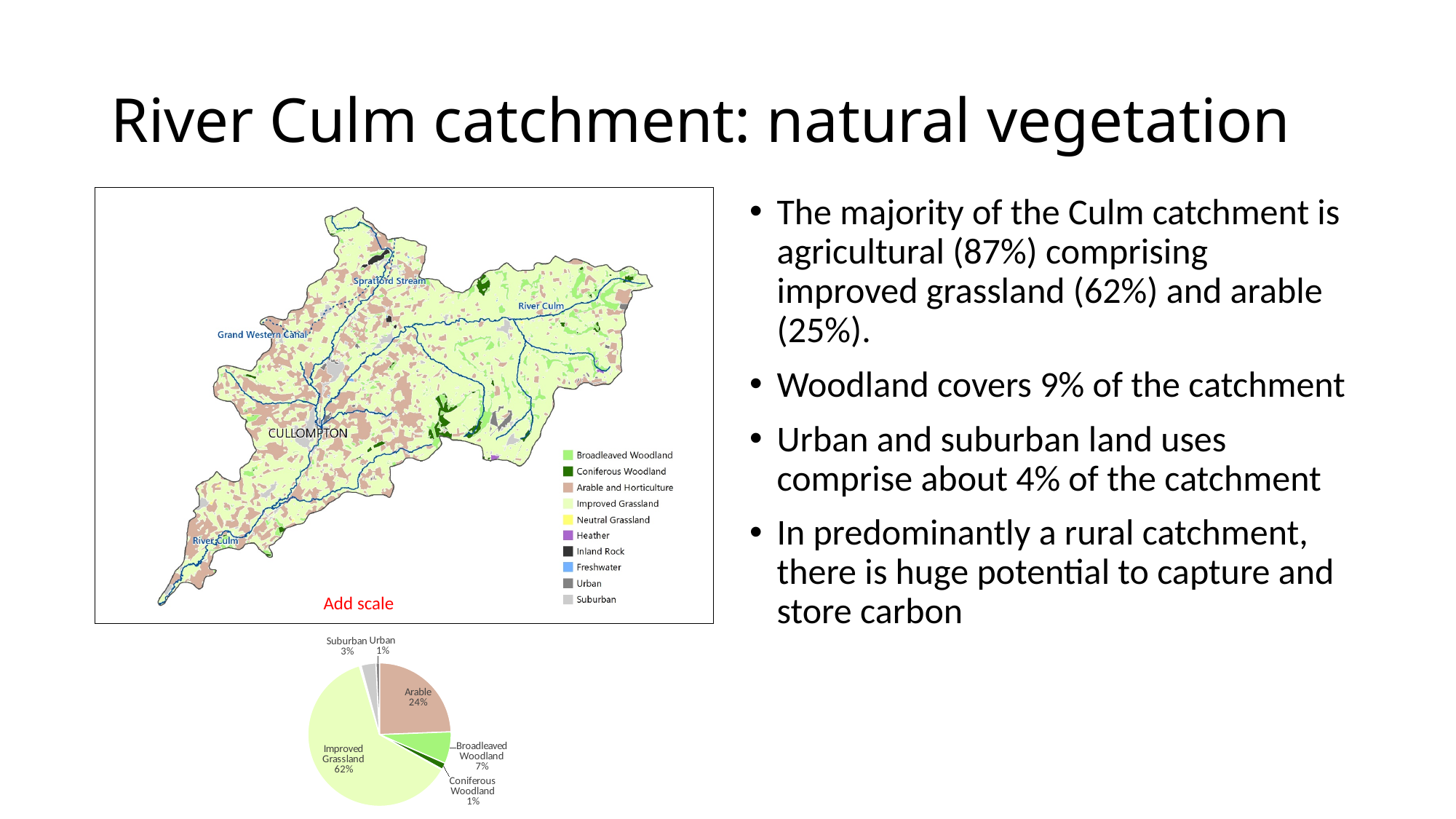
In the pie chart, what is the combined share of Broadleaved Woodland and Coniferous Woodland? 8% What kind of chart is shown at the bottom left of the slide? pie chart In the pie chart, what share does Coniferous Woodland have? 1% In the pie chart, which is larger: Arable or Broadleaved Woodland? Arable In the pie chart, what share does Broadleaved Woodland have? 7% In the pie chart, what is the difference between the Improved Grassland share and the Arable share? 38% In the pie chart, which is larger: Broadleaved Woodland or Suburban? Broadleaved Woodland In the pie chart, what share does Suburban have? 3% In the pie chart, what share does Improved Grassland have? 62% Which slice of the pie chart is the largest? Improved Grassland In the pie chart, what share does Arable have? 24%